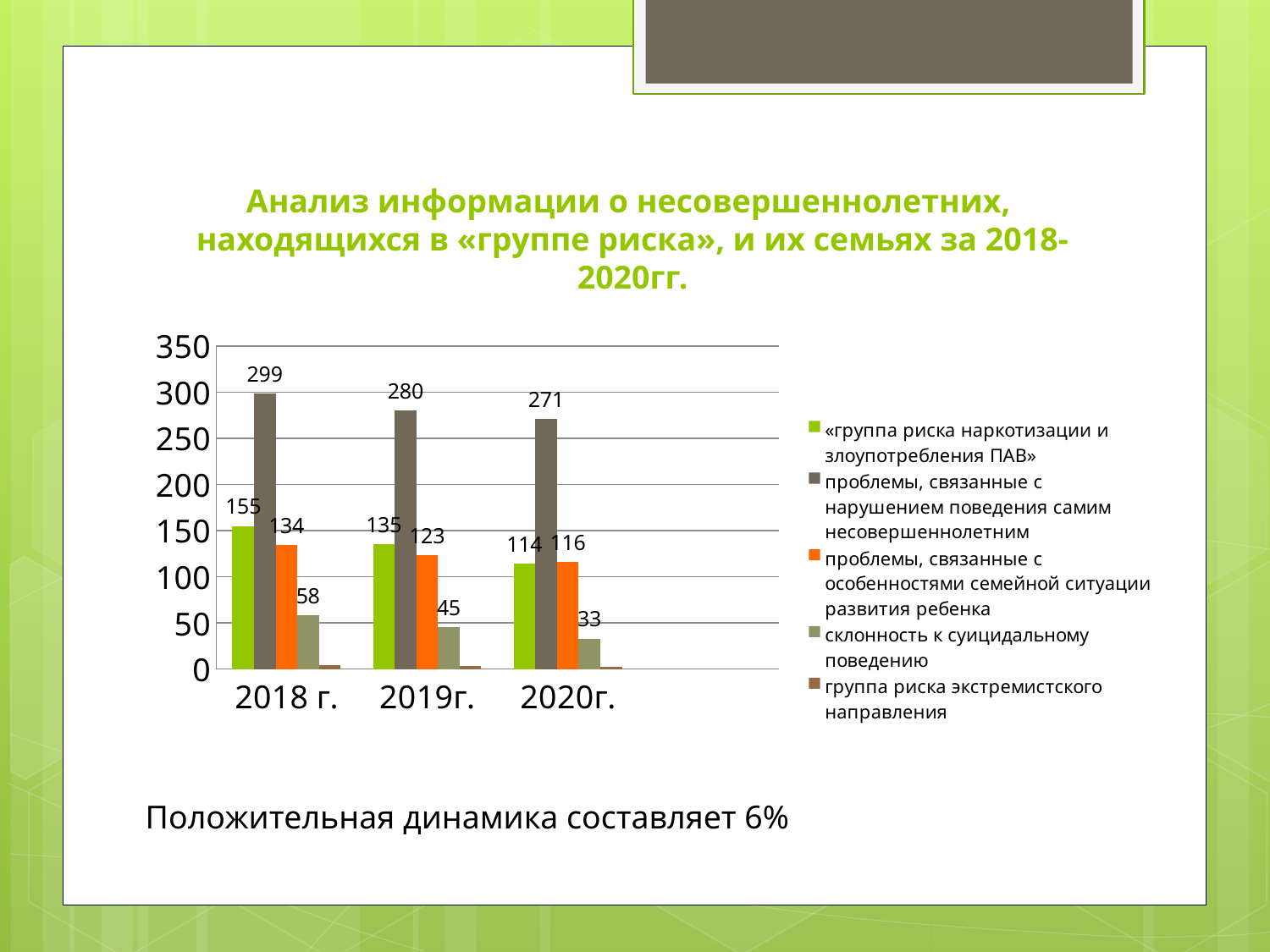
What type of chart is shown on the slide? bar chart In which year is the value for «склонность к суицидальному поведению» lowest? 2020г. Is the value for «группа риска экстремистского направления» in 2018 г. greater or less than 50? less How many series does the legend list? 5 In which year is the value for «проблемы, связанные с нарушением поведения самим несовершеннолетним» highest? 2018 г. How many year categories are shown on the x axis? 3 What is the value for «группа риска наркотизации и злоупотребления ПАВ» in 2020г.? 114 What is the value for «склонность к суицидальному поведению» in 2019г.? 45 Does the value for «склонность к суицидальному поведению» rise or fall from 2018 г. to 2020г.? fall What is the value for «проблемы, связанные с нарушением поведения самим несовершеннолетним» in 2018 г.? 299 Which is larger in 2020г.: «группа риска наркотизации и злоупотребления ПАВ» or «проблемы, связанные с особенностями семейной ситуации развития ребенка»? проблемы, связанные с особенностями семейной ситуации развития ребенка What is the difference between the 2018 г. and 2020г. values for «проблемы, связанные с нарушением поведения самим несовершеннолетним»? 28